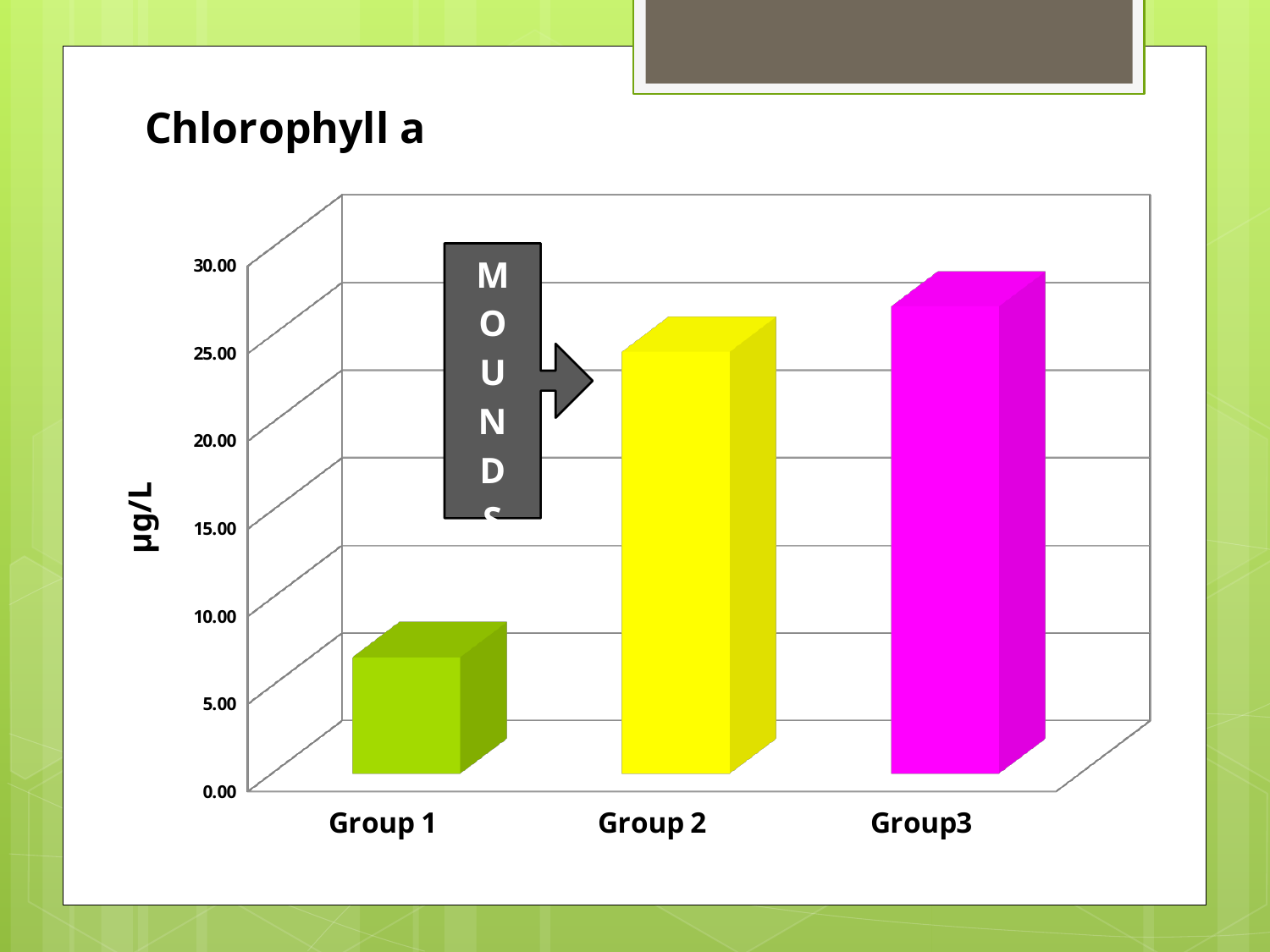
What is the title of the chart? Chlorophyll a Which group has the lowest chlorophyll a value? Group 1 Which has a larger value, Group 2 or Group3? Group3 Which group has the highest chlorophyll a value? Group3 How many groups are plotted on the chart? 3 What unit is shown on the vertical axis label? µg/L Is the value for Group 1 greater or less than 10.00? less Is the value for Group 2 greater or less than 20.00? greater Is the value for Group3 greater or less than 30.00? less What kind of chart is shown on the slide? bar chart Do the values rise or fall from Group 1 to Group3? rise Which has a larger value, Group 1 or Group 2? Group 2